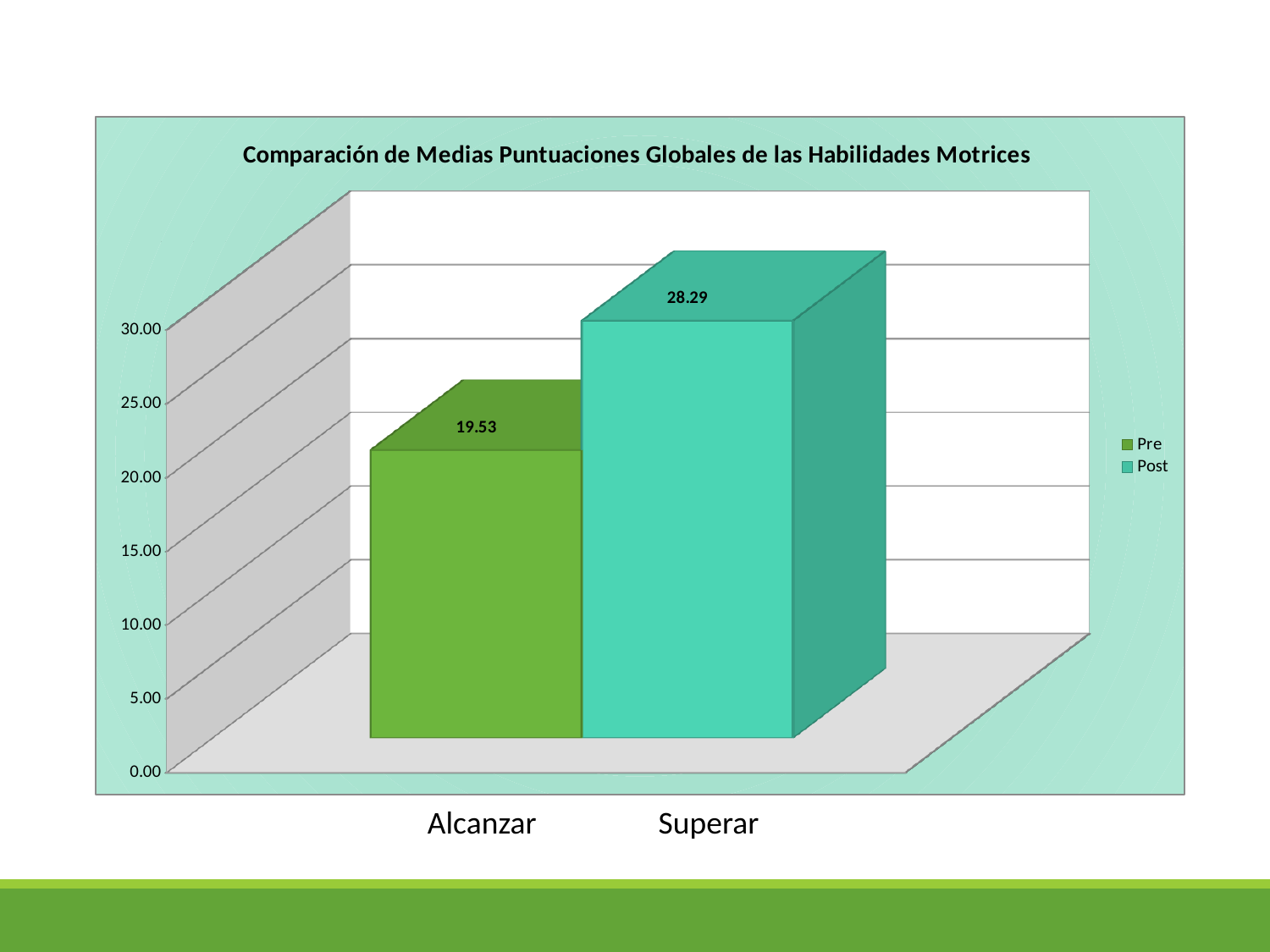
Which bar is the highest in the chart? Post What is the value of the Pre bar? 19.53 How many series does the legend list? 2 Is the value for Post greater or less than 25.00? greater Is the value for Pre greater or less than 20.00? less What is the value of the Post bar? 28.29 What is the title of the chart? Comparación de Medias Puntuaciones Globales de las Habilidades Motrices Which bar is the lowest in the chart? Pre What is the difference between the Post value and the Pre value? 8.76 What kind of chart is shown on the slide? Bar chart Which series has the higher value, Pre or Post? Post How many bars are plotted in the chart? 2